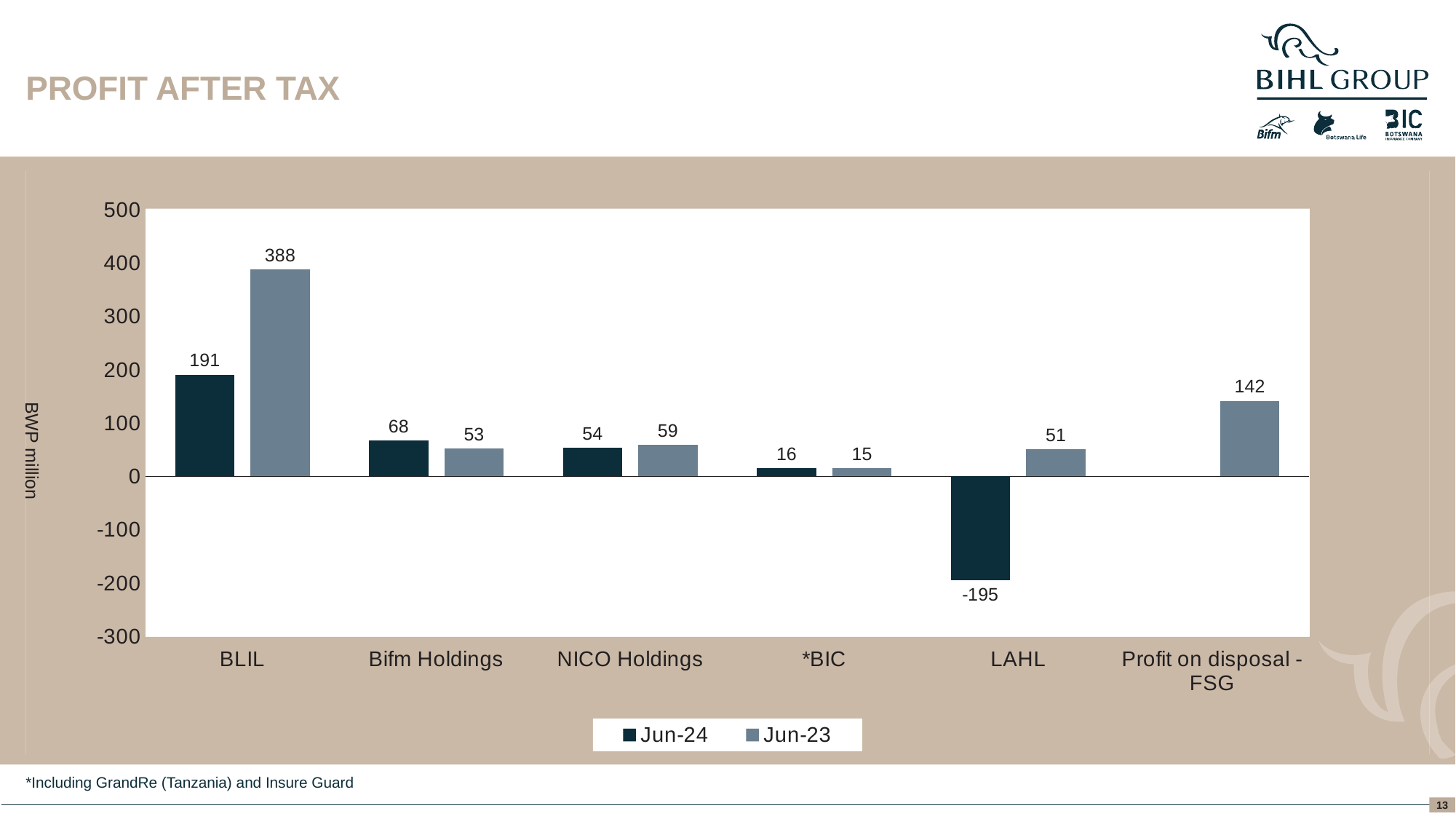
What is the y-axis label of the chart? BWP million What kind of chart is shown on the slide? Bar chart What is the Jun-24 profit after tax for BLIL? 191 What is the difference between the Jun-23 and Jun-24 values for BLIL? 197 What is the Jun-24 value for LAHL? -195 How many series does the legend list? 2 Which category has the lowest Jun-24 value? LAHL How many categories are shown on the x axis? 6 What is the Jun-23 value for Profit on disposal - FSG? 142 Which category has the highest Jun-23 value? BLIL What is the difference between the Jun-24 and Jun-23 values for Bifm Holdings? 15 Which is larger for NICO Holdings, the Jun-24 value or the Jun-23 value? Jun-23